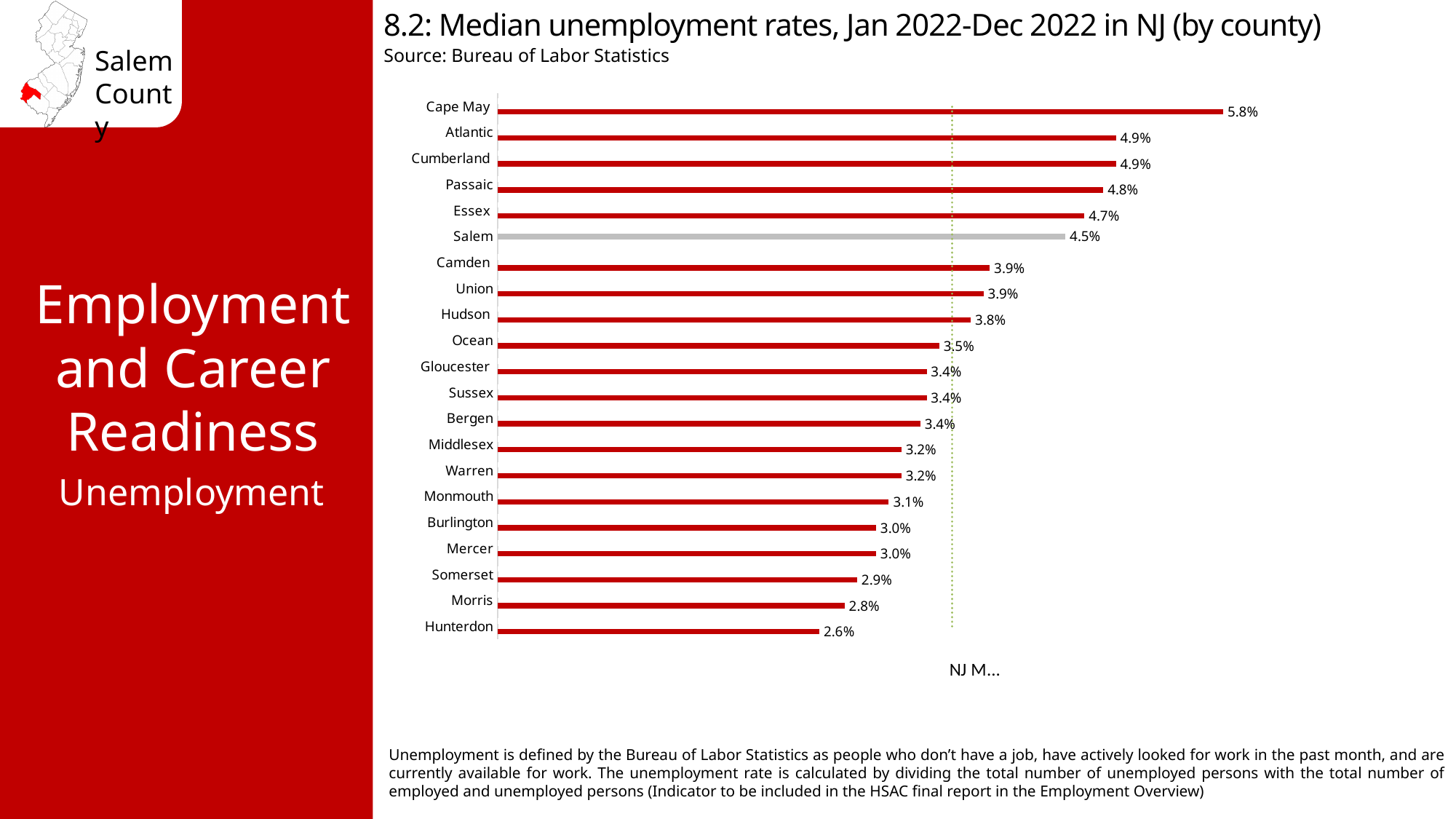
Which county has a higher median unemployment rate, Salem or Passaic? Passaic Which county's bar is shown in grey instead of red? Salem How many counties are shown in the chart? 21 What is the median unemployment rate for Salem county? 4.5% What is the median unemployment rate for Cape May county? 5.8% What is the median unemployment rate for Hunterdon county? 2.6% Which county has the highest median unemployment rate? Cape May Which county has the lowest median unemployment rate? Hunterdon What type of chart is used to show the median unemployment rates? Bar chart What is the difference between the median unemployment rates of Cape May and Salem? 1.3% What is the difference between the median unemployment rates of Salem and Hunterdon? 1.9% Which county has a higher median unemployment rate, Essex or Camden? Essex